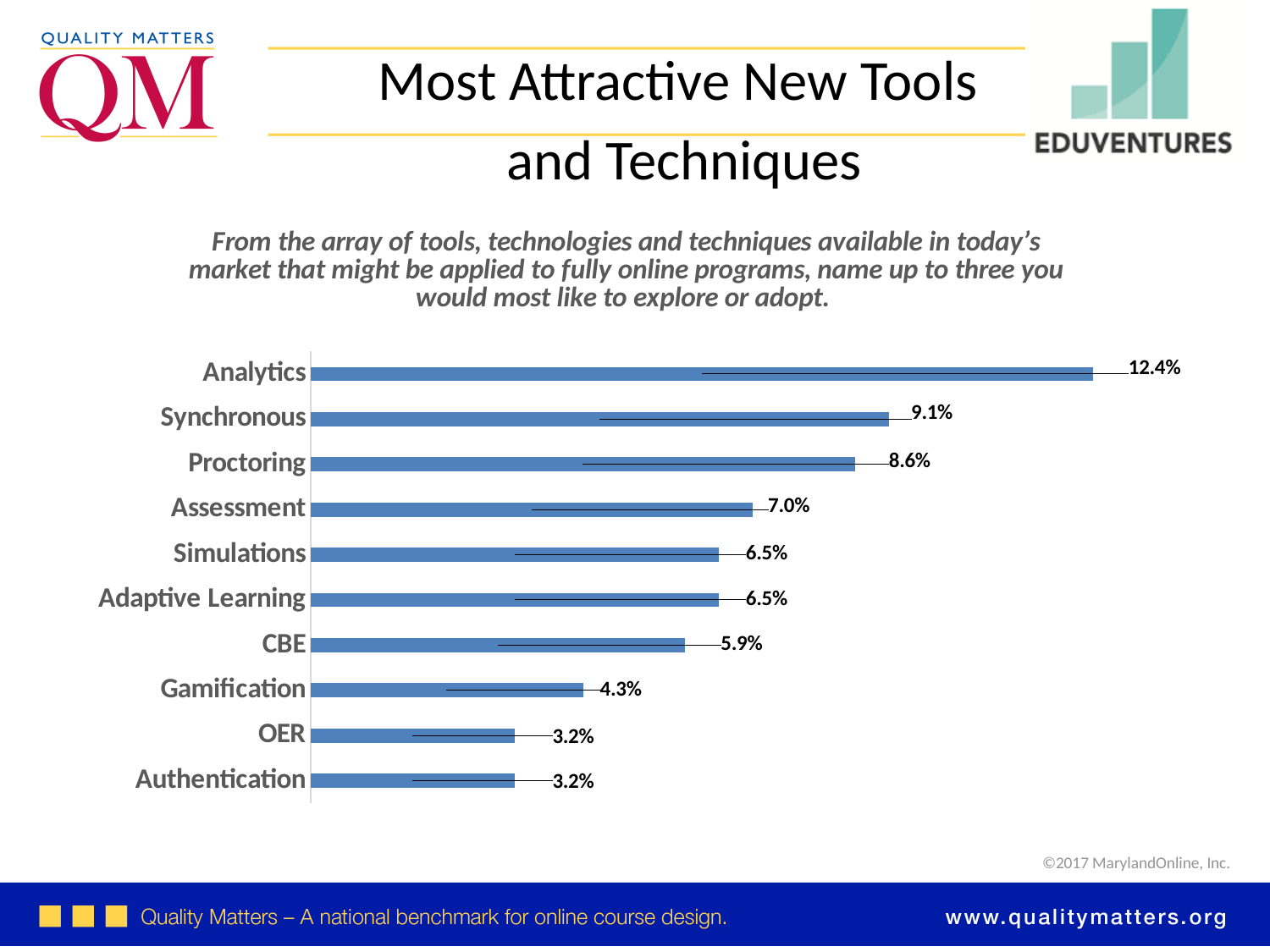
What is the difference between the values for Assessment and Gamification? 2.7% What is the value for Proctoring? 8.6% What is the difference between the values for Analytics and Synchronous? 3.3% What is the value for CBE? 5.9% What is the value for Analytics? 12.4% What kind of chart is shown on the slide? Bar chart Which is larger, the value for CBE or the value for Simulations? Simulations Which category has the highest value? Analytics What is the value for Gamification? 4.3% Which is larger, the value for Synchronous or the value for Proctoring? Synchronous How many categories are shown in the chart? 10 What is the title of the slide containing the chart? Most Attractive New Tools and Techniques